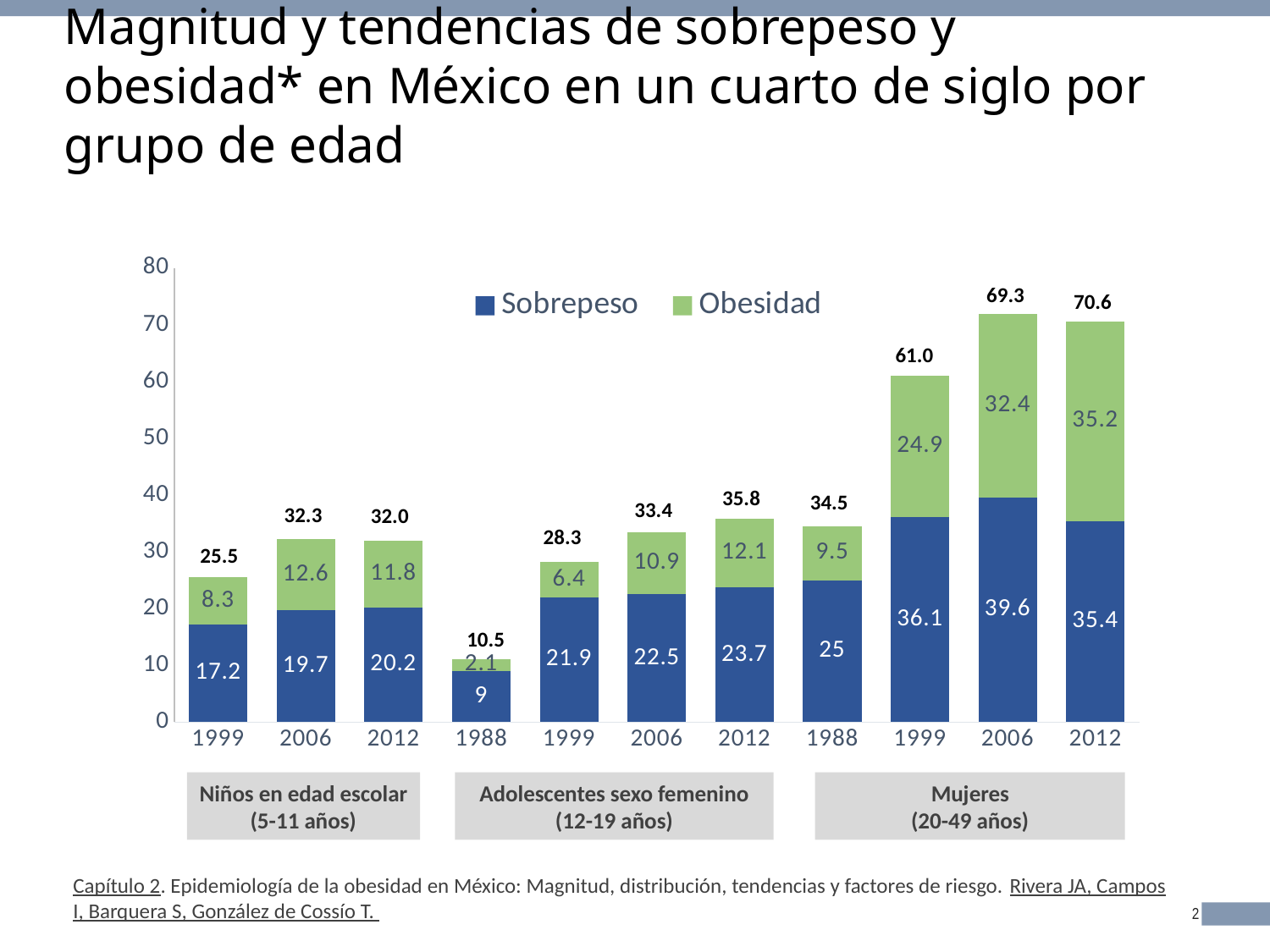
What kind of chart is shown on the slide? Stacked bar chart Which bar has the lowest total value? Adolescentes sexo femenino (12-19 años) 1988 What is the difference between the Obesidad values for Mujeres (20-49 años) in 2012 and 1999? 10.3 Which colour represents Obesidad in the chart? Green What is the Obesidad value for Niños en edad escolar (5-11 años) in 1999? 8.3 Do the total values for Mujeres (20-49 años) rise or fall from 1988 to 2012? Rise How many series does the legend list? 2 What is the Sobrepeso value for Mujeres (20-49 años) in 2006? 39.6 How many bars are plotted in the chart? 11 What is the total printed above the bar for Adolescentes sexo femenino (12-19 años) in 2012? 35.8 Which bar has the highest total value? Mujeres (20-49 años) 2012 Which is larger: the Sobrepeso value for Niños en edad escolar in 2012 or the Sobrepeso value for Adolescentes sexo femenino in 2012? Adolescentes sexo femenino in 2012